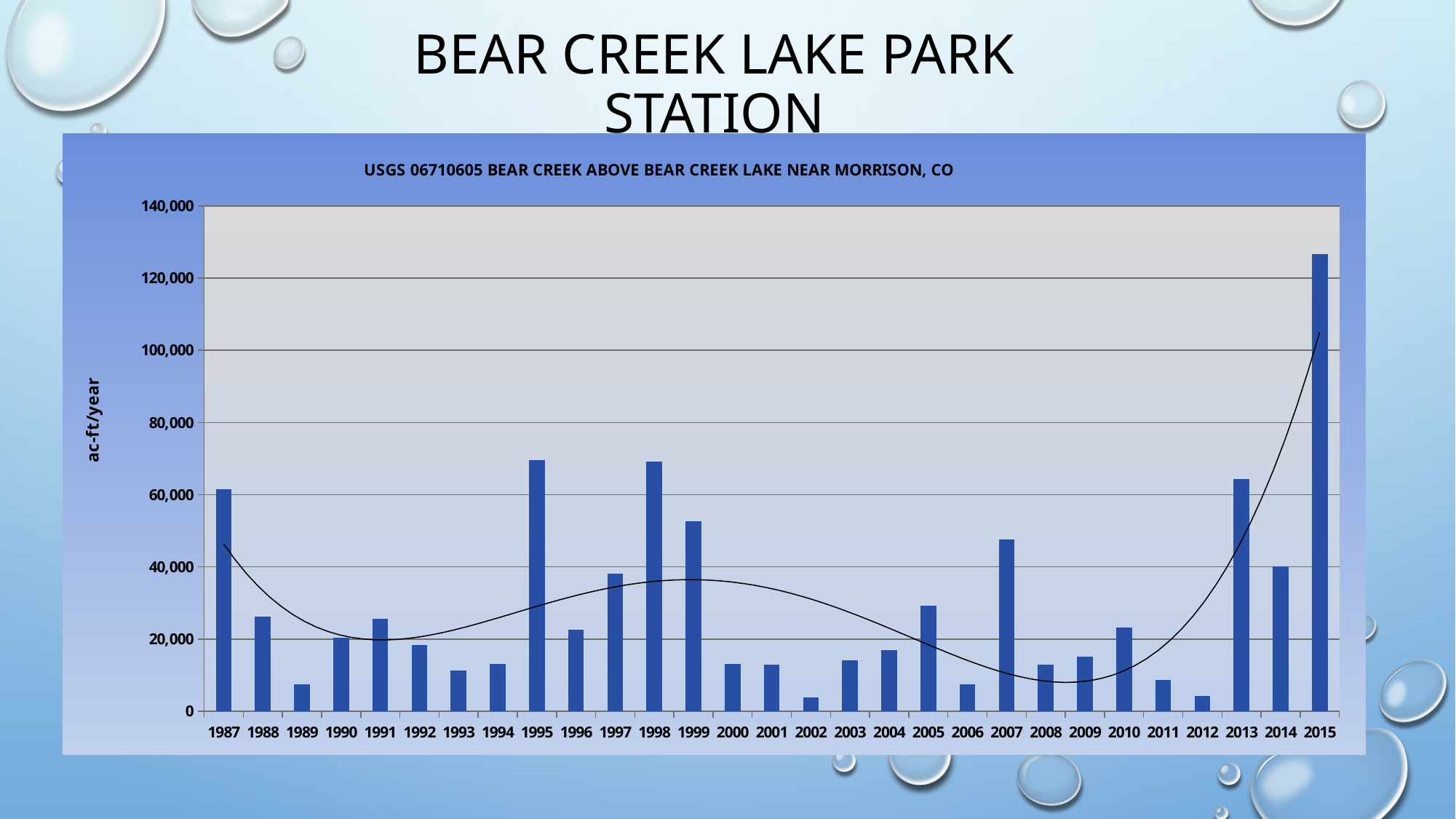
Which year has the highest value in the chart? 2015 Which year has the larger value, 1987 or 1988? 1987 Is the value for 1995 greater or less than 60,000? greater What kind of chart is shown on the slide? bar chart Is the value for 2014 greater or less than 60,000? less What is the label on the y axis of the chart? ac-ft/year Is the value for 1989 greater or less than 10,000? less What is the title of the chart? USGS 06710605 BEAR CREEK ABOVE BEAR CREEK LAKE NEAR MORRISON, CO Which year has the larger value, 2013 or 2007? 2013 How many years are shown on the x axis of the chart? 29